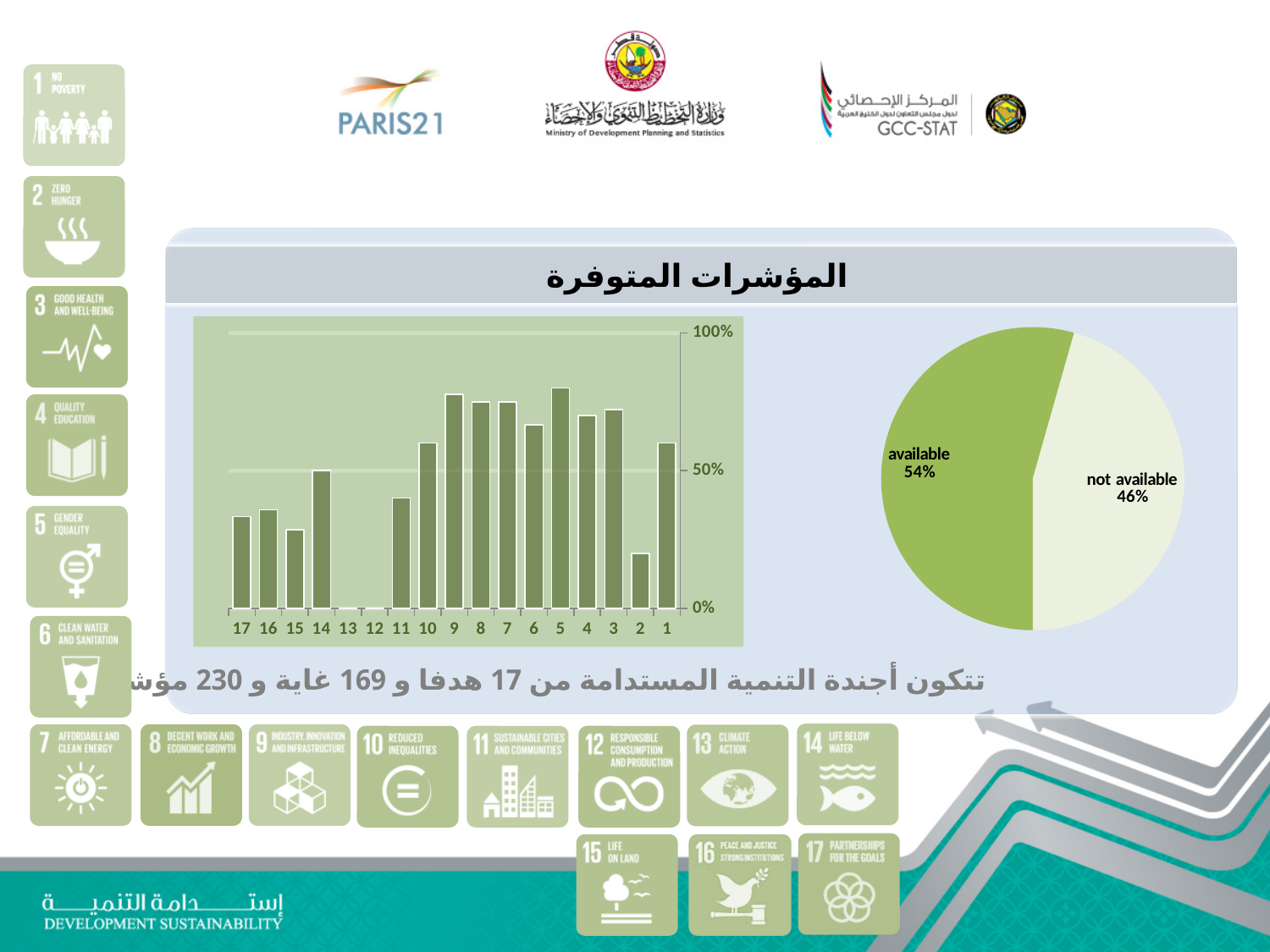
In the pie chart on the right, what is the difference in percentage points between the available and not available slices? 8 In the pie chart on the right, what percentage of indicators is not available? 46% In the bar chart on the left, which has the larger value, category 9 or category 2? 9 How many categories are shown on the x axis of the bar chart on the left? 17 What kind of chart is shown on the right of the slide? pie chart What kind of chart is shown on the left of the slide? bar chart In the pie chart on the right, which slice is larger, available or not available? available In the bar chart on the left, is the value for category 17 greater or less than 50%? less In the bar chart on the left, is the value for category 9 greater or less than 50%? greater In the pie chart on the right, what percentage of indicators is available? 54% How many slices does the pie chart on the right have? 2 In the bar chart on the left, is the value for category 2 greater or less than 50%? less